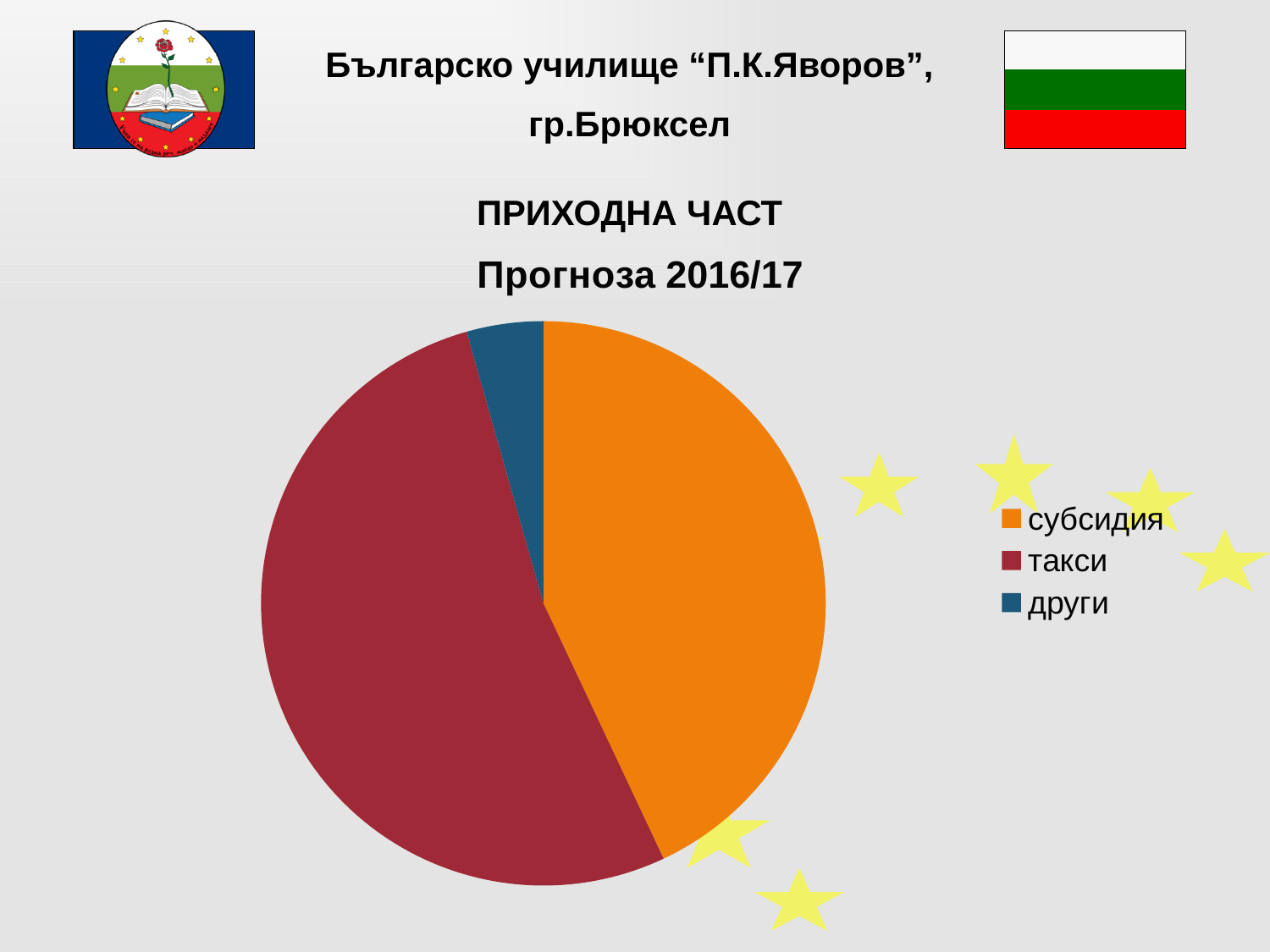
What colour is the слice for такси in the pie chart? red How many slices does the pie chart have? 3 How many entries does the legend of the pie chart list? 3 Which slice is larger in the pie chart, други or субсидия? субсидия What kind of chart is shown on the slide? pie chart What is the title of the chart on the slide? Прогноза 2016/17 Which slice is larger in the pie chart, субсидия or такси? такси Which category has the largest slice in the pie chart? такси Which slice is larger in the pie chart, такси or други? такси Which category has the smallest slice in the pie chart? други